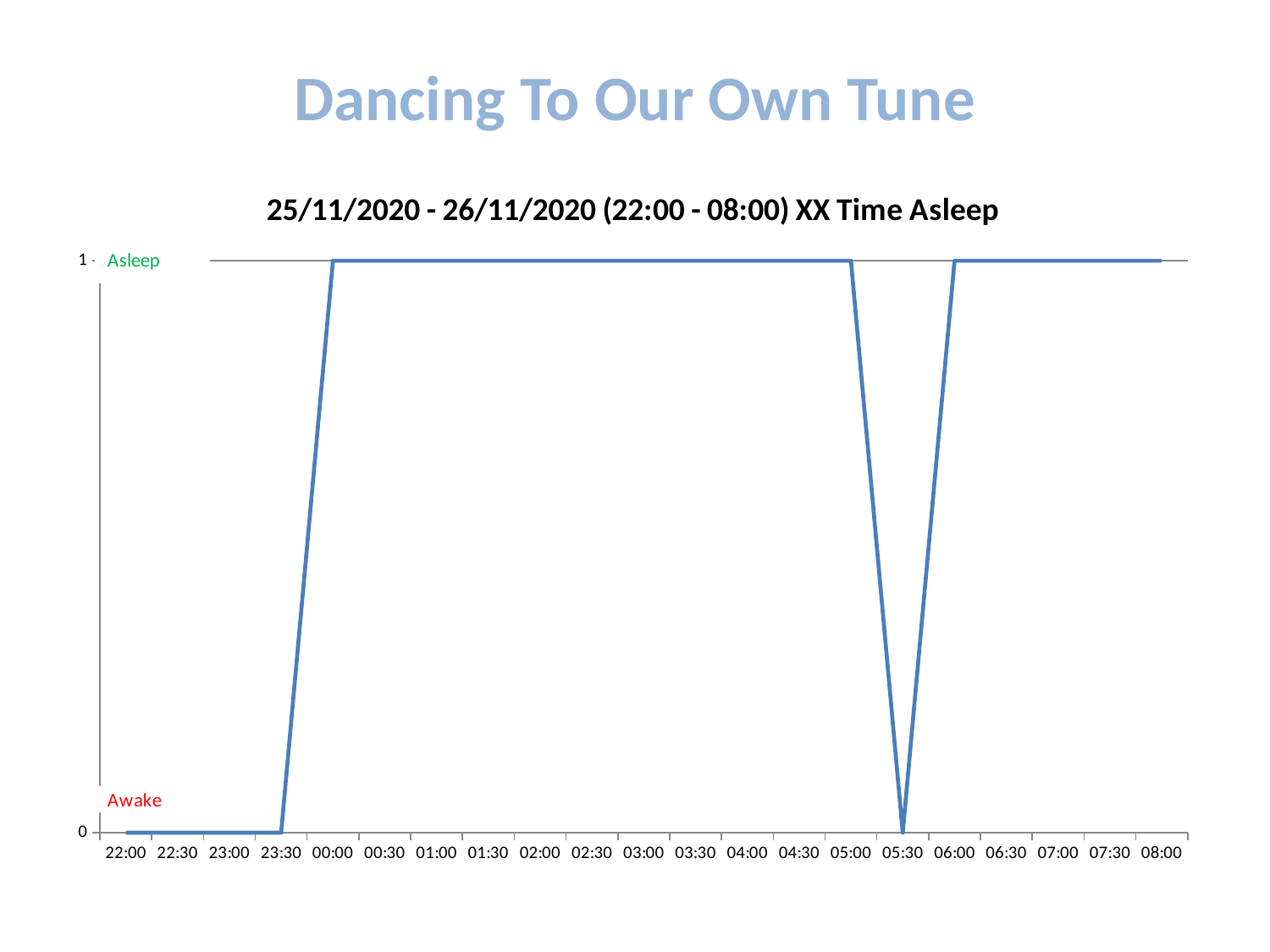
What is the difference between the value at 06:00 and the value at 05:30? 1 What is the value at 23:30? 0 What kind of chart is shown on the slide? line chart Does the value rise or fall between 23:30 and 00:00? rise What is the value at 05:30? 0 What is the value at 00:00? 1 Which label on the y axis corresponds to the value 1? Asleep What is the value at 22:00? 0 How many time points are labelled on the x axis? 21 What is the value at 08:00? 1 Which is larger, the value at 03:00 or the value at 05:30? 03:00 What is the title of the chart? 25/11/2020 - 26/11/2020 (22:00 - 08:00) XX Time Asleep